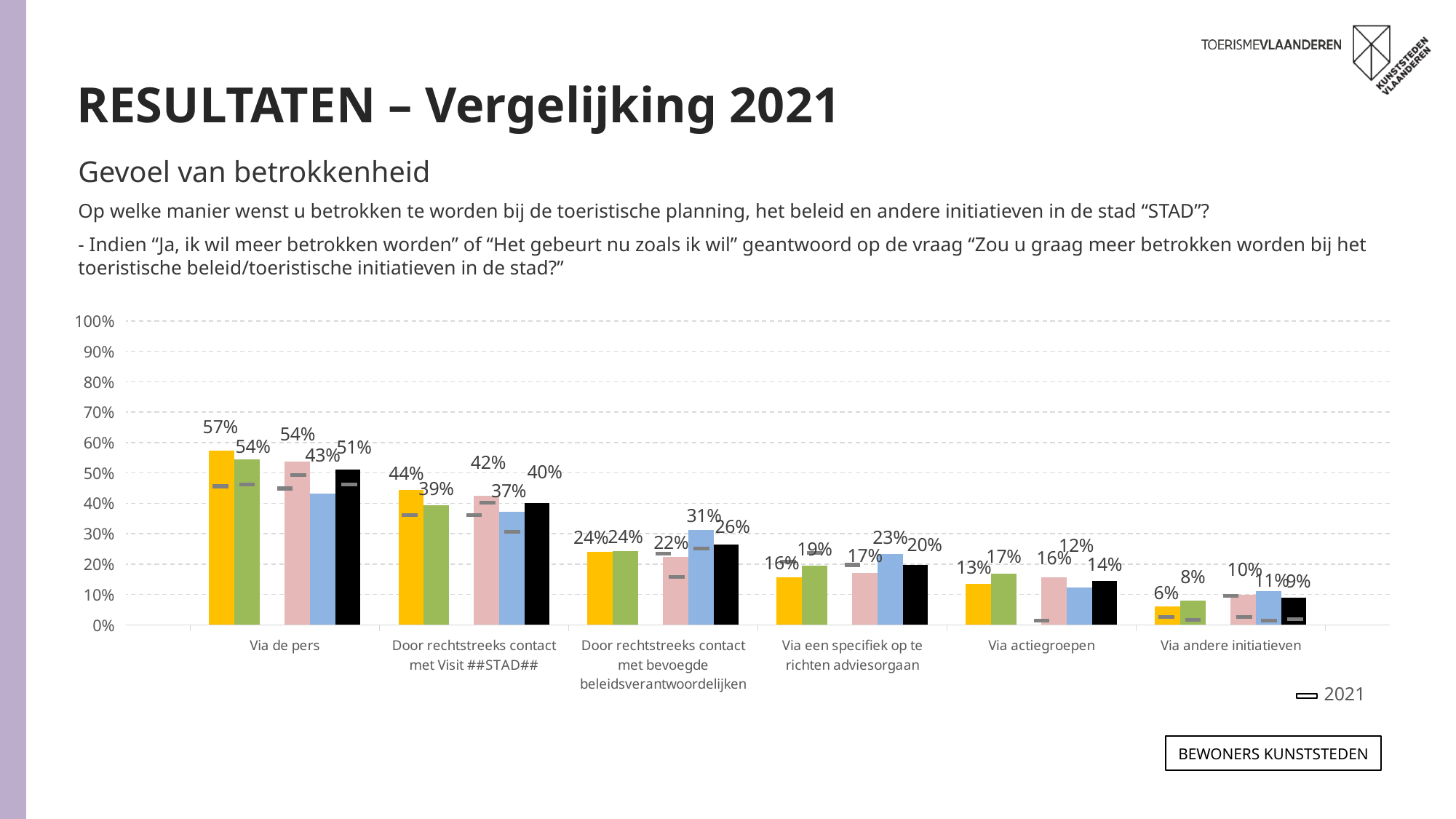
What is the value of the blue bar for "Door rechtstreeks contact met bevoegde beleidsverantwoordelijken"? 31% What is the difference between the yellow bar and the blue bar for "Via de pers"? 14% What is the value of the pink bar for "Via andere initiatieven"? 10% How many categories are shown along the x axis of the chart? 6 Is the 2021 marker for the yellow bar of "Via de pers" greater or less than 50%? less Which category has the highest value for the yellow bars? Via de pers What entry does the chart legend list? 2021 What is the value of the yellow bar for "Via de pers"? 57% What is the value of the black bar for "Via actiegroepen"? 14% Which category has the lowest value for the green bars? Via andere initiatieven For "Via een specifiek op te richten adviesorgaan", which is larger: the blue bar or the yellow bar? the blue bar What kind of chart is shown on the slide? bar chart